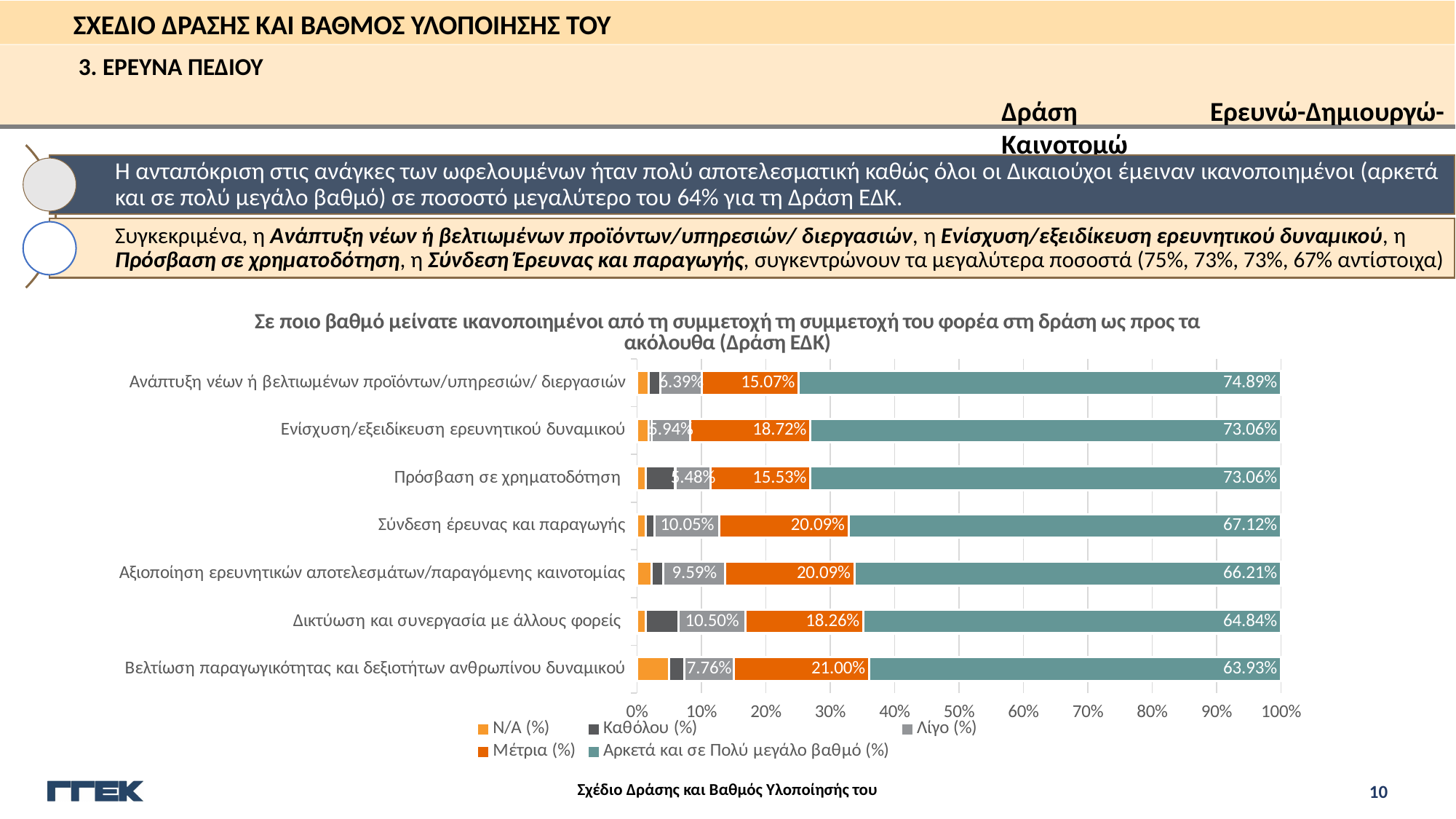
What is the value of 'Αρκετά και σε Πολύ μεγάλο βαθμό (%)' for 'Ανάπτυξη νέων ή βελτιωμένων προϊόντων/υπηρεσιών/ διεργασιών'? 74.89% What is the value of 'Μέτρια (%)' for 'Πρόσβαση σε χρηματοδότηση'? 15.53% How many categories are plotted on the y axis of the chart? 7 Which has the larger 'Μέτρια (%)' value: 'Σύνδεση έρευνας και παραγωγής' or 'Ενίσχυση/εξειδίκευση ερευνητικού δυναμικού'? Σύνδεση έρευνας και παραγωγής What kind of chart is shown on the slide? Stacked bar chart What is the value of 'Λίγο (%)' for 'Δικτύωση και συνεργασία με άλλους φορείς'? 10.50% What is the value of 'Μέτρια (%)' for 'Βελτίωση παραγωγικότητας και δεξιοτήτων ανθρωπίνου δυναμικού'? 21.00% Is the 'N/A (%)' value for 'Βελτίωση παραγωγικότητας και δεξιοτήτων ανθρωπίνου δυναμικού' greater or less than 10%? less What is the difference between the 'Αρκετά και σε Πολύ μεγάλο βαθμό (%)' values for 'Ανάπτυξη νέων ή βελτιωμένων προϊόντων/υπηρεσιών/ διεργασιών' and 'Βελτίωση παραγωγικότητας και δεξιοτήτων ανθρωπίνου δυναμικού'? 10.96 percentage points Which category has the highest value for 'Αρκετά και σε Πολύ μεγάλο βαθμό (%)'? Ανάπτυξη νέων ή βελτιωμένων προϊόντων/υπηρεσιών/ διεργασιών Which category has the lowest value for 'Αρκετά και σε Πολύ μεγάλο βαθμό (%)'? Βελτίωση παραγωγικότητας και δεξιοτήτων ανθρωπίνου δυναμικού How many series does the chart legend list? 5